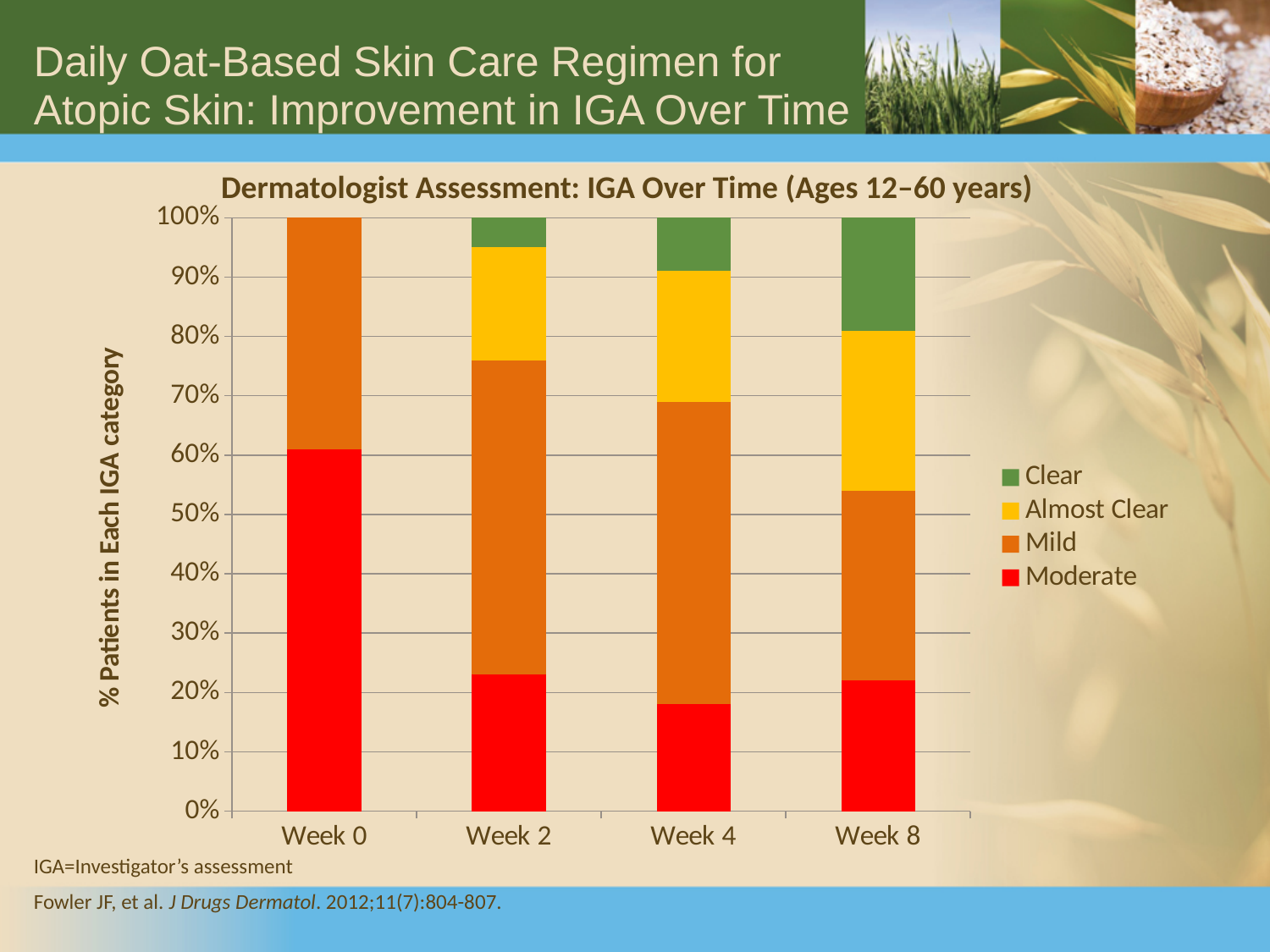
Which week has the largest Moderate segment? Week 0 What kind of chart is shown on the slide? Stacked bar chart Which is larger, the Moderate share at Week 0 or at Week 8? Week 0 How many weeks (categories) are shown on the x axis? 4 What is the title of the chart? Dermatologist Assessment: IGA Over Time (Ages 12–60 years) Is the Moderate share at Week 8 greater or less than 30%? less How many series does the legend list? 4 Which week has the largest Clear segment? Week 8 Does the Clear share rise or fall from Week 0 to Week 8? Rises Is the Moderate share at Week 2 greater or less than 30%? less Is the Moderate share at Week 0 greater or less than 50%? greater Which is larger, the Clear share at Week 2 or at Week 8? Week 8